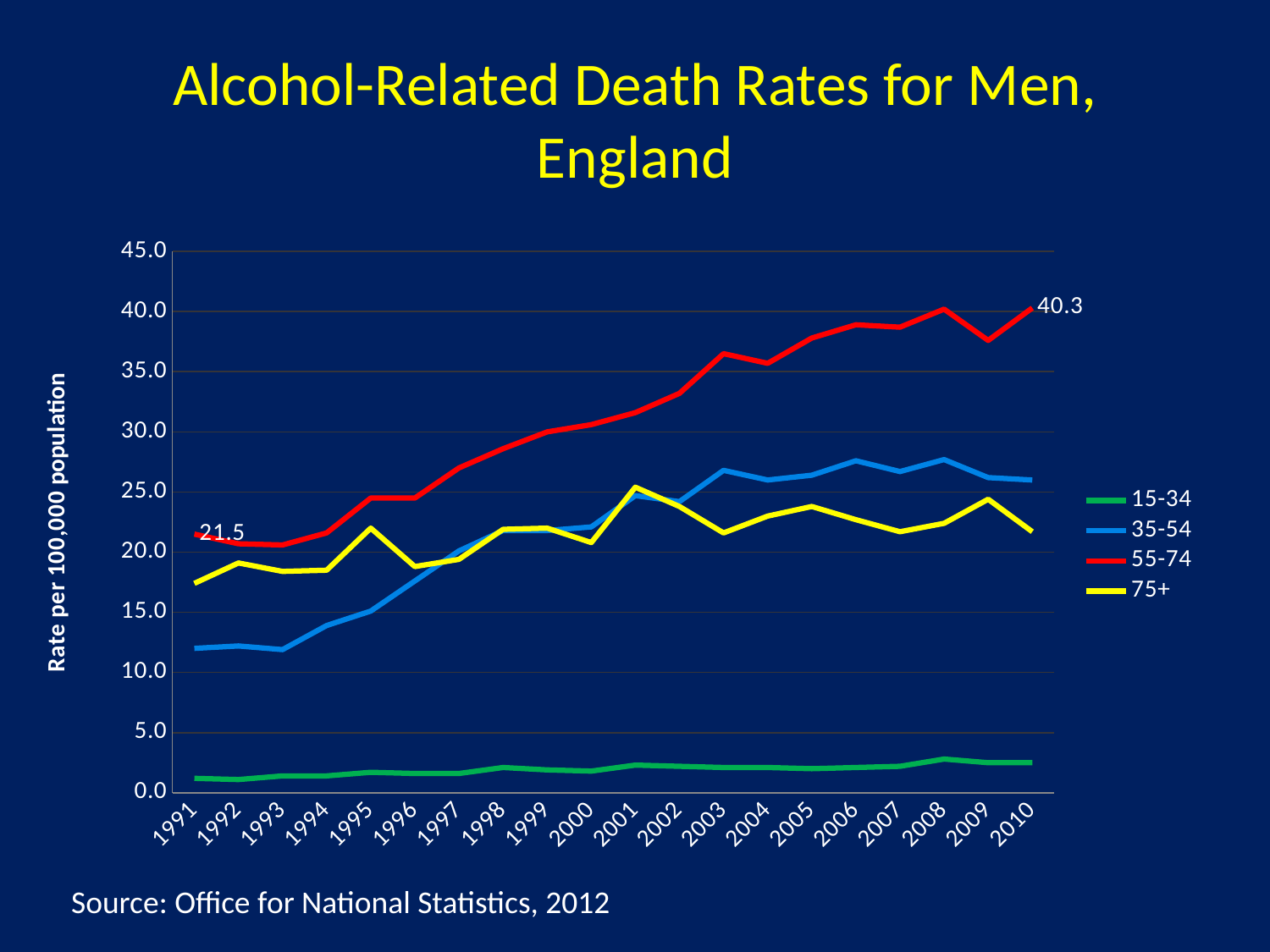
Does the death rate for men aged 55-74 generally rise or fall from 1991 to 2010? rise What is the label on the vertical axis? Rate per 100,000 population Which age group has the highest death rate in 2010? 55-74 Is the value for the 35-54 age group in 2010 greater or less than 20.0? greater What is the alcohol-related death rate for men aged 55-74 in 2010? 40.3 By how much did the death rate for men aged 55-74 increase between 1991 and 2010? 18.8 How many series does the legend list? 4 What kind of chart is shown on the slide? line chart What is the alcohol-related death rate for men aged 55-74 in 1991? 21.5 Which age group has the lowest death rate across the whole period? 15-34 How many years are plotted along the x axis? 20 In 1991, which age group has the larger death rate, 35-54 or 75+? 75+